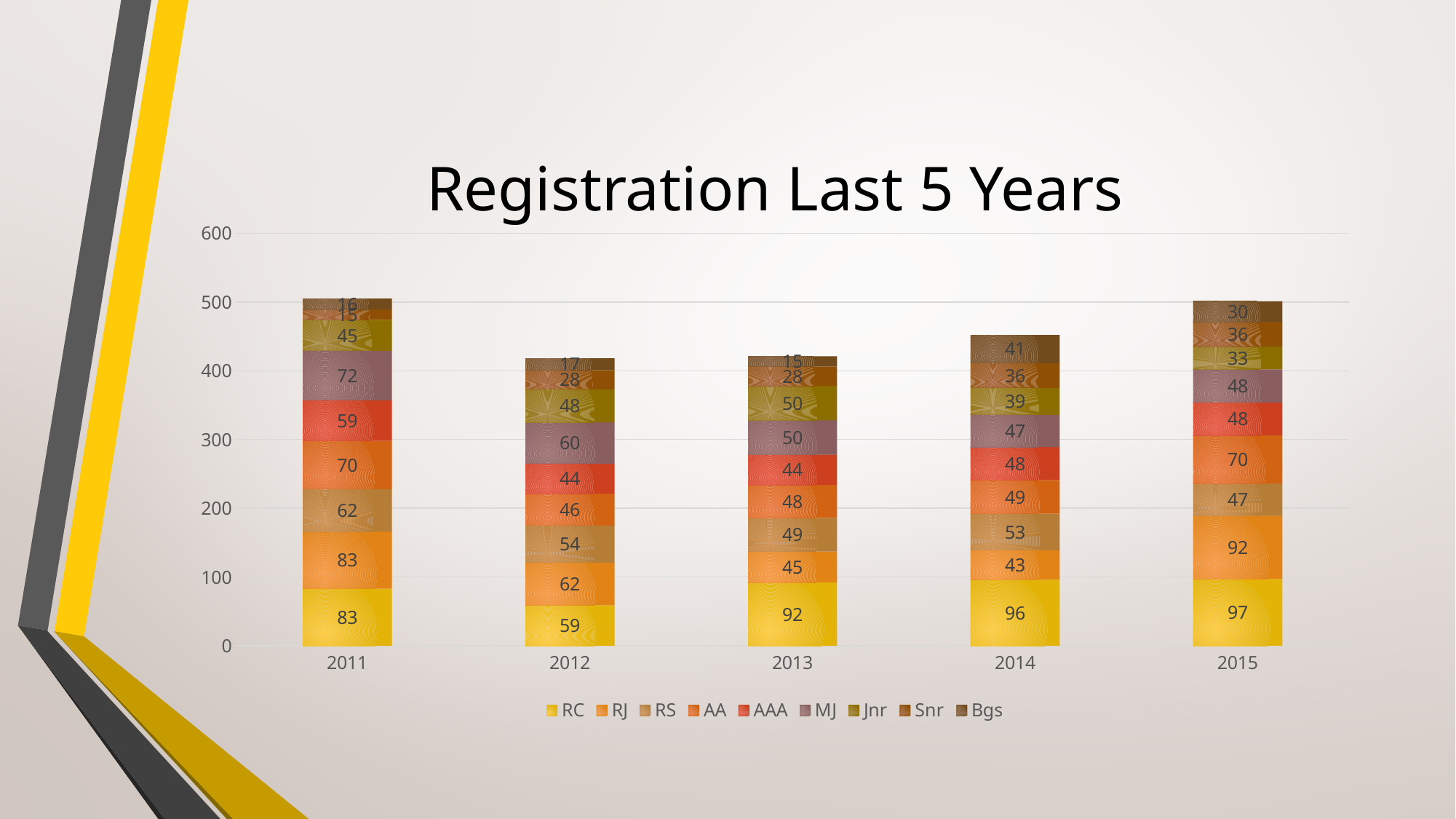
How many series does the legend list? 9 What is the RC value for 2015? 97 What is the MJ value for 2011? 72 What type of chart is shown on the slide? stacked bar chart Which is larger, the AA value for 2011 or the AA value for 2012? 2011 What is the title of the chart? Registration Last 5 Years What is the difference between the RJ values for 2015 and 2014? 49 How many years are shown on the x axis? 5 What is the total of the stacked bar for 2014? 452 Which year has the lowest RJ value? 2014 What is the Bgs value for 2014? 41 Which year has the highest RC value? 2015